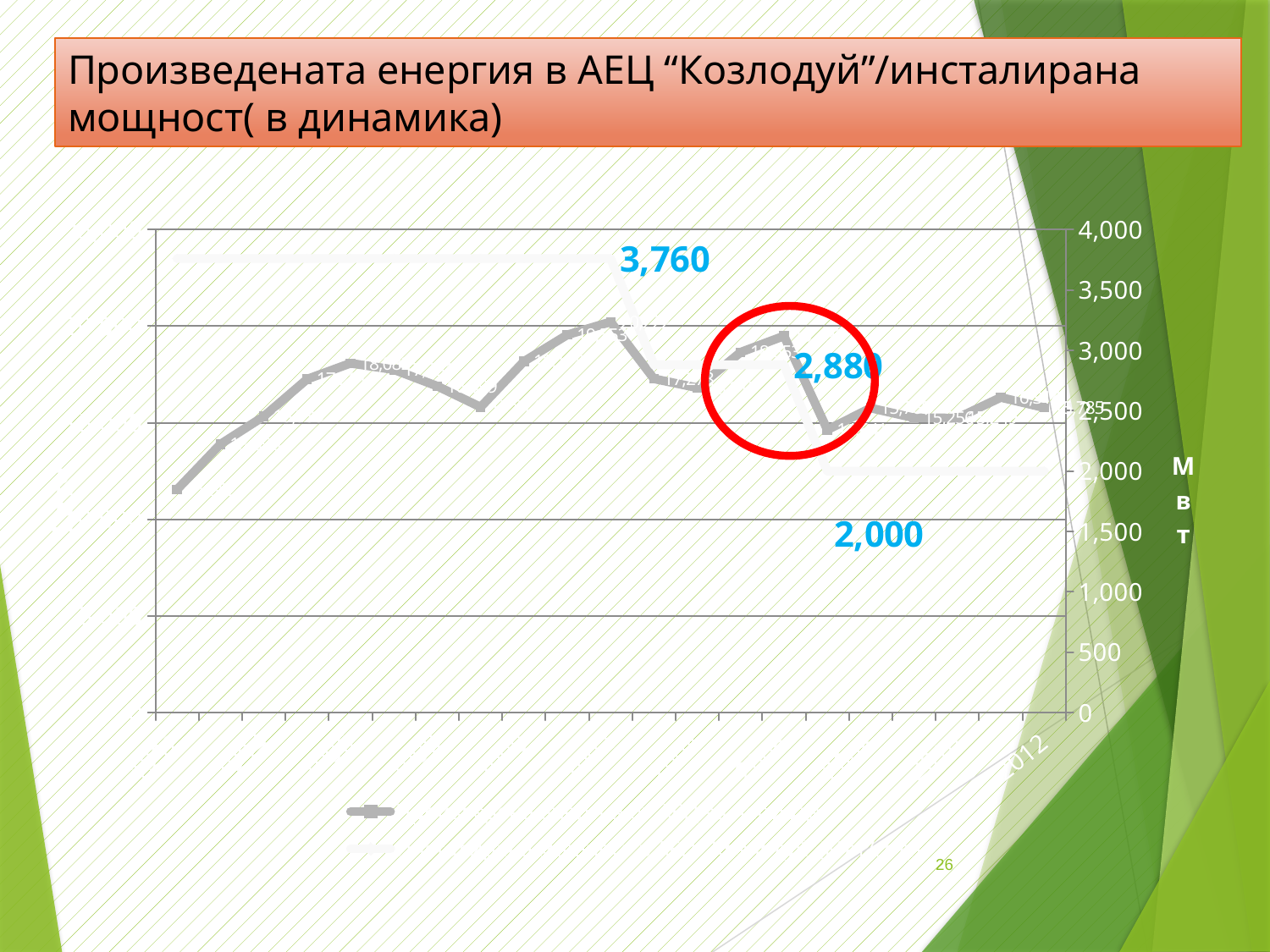
What is the difference between the blue-labelled values 3,760 and 2,880? 880 Which of the blue-labelled values is larger, 3,760 or 2,880? 3,760 What is the difference between the blue-labelled values 2,880 and 2,000? 880 What is the highest installed-capacity value labelled in blue on the chart? 3,760 Is the highest point of the grey produced-energy line greater or less than 3,000? greater Does the grey produced-energy line end higher or lower than it starts? higher Is the last point of the grey produced-energy line (2012) greater or less than 2,000? greater What is the lowest installed-capacity value labelled in blue on the chart? 2,000 What kind of chart is shown on the slide? line chart What is the title of the slide's chart? Произведената енергия в АЕЦ "Козлодуй"/инсталирана мощност( в динамика) What is the highest value shown on the vertical axis of the chart? 4,000